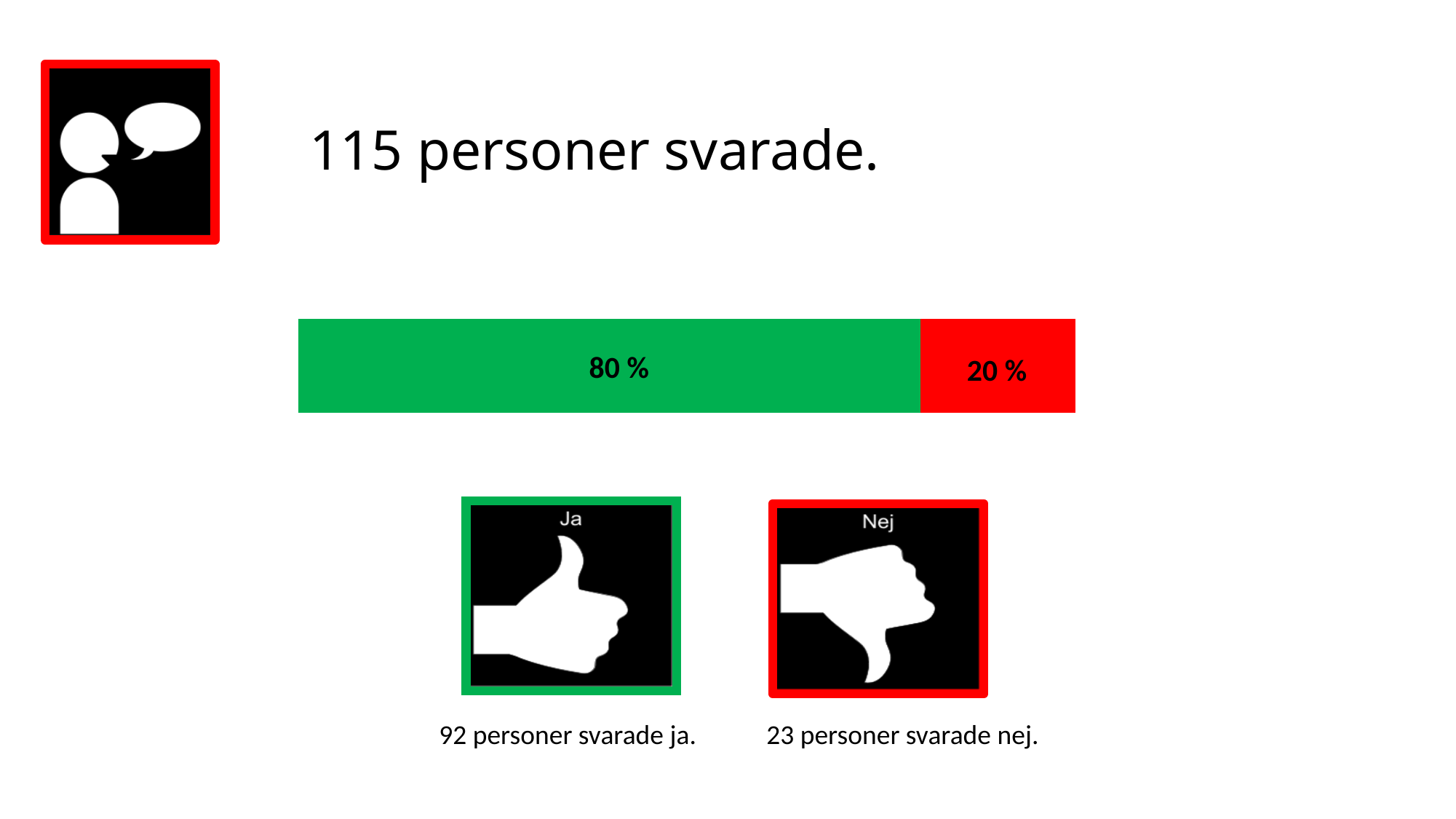
What percentage is shown on the red segment of the bar? 20 % According to the slide, how many people answered in total? 115 Which segment of the bar has the smaller value, the green one or the red one? the red one Is the value of the green segment larger or smaller than the value of the red segment? larger Which segment of the bar has the larger value, the green one or the red one? the green one What is the difference between the green segment's value and the red segment's value? 60 % What kind of chart is shown on the slide? bar chart What do the two segments of the bar add up to? 100 % What colour is the segment of the bar that corresponds to the 'Ja' answer? green How many segments does the bar have? 2 What percentage is shown on the green segment of the bar? 80 %